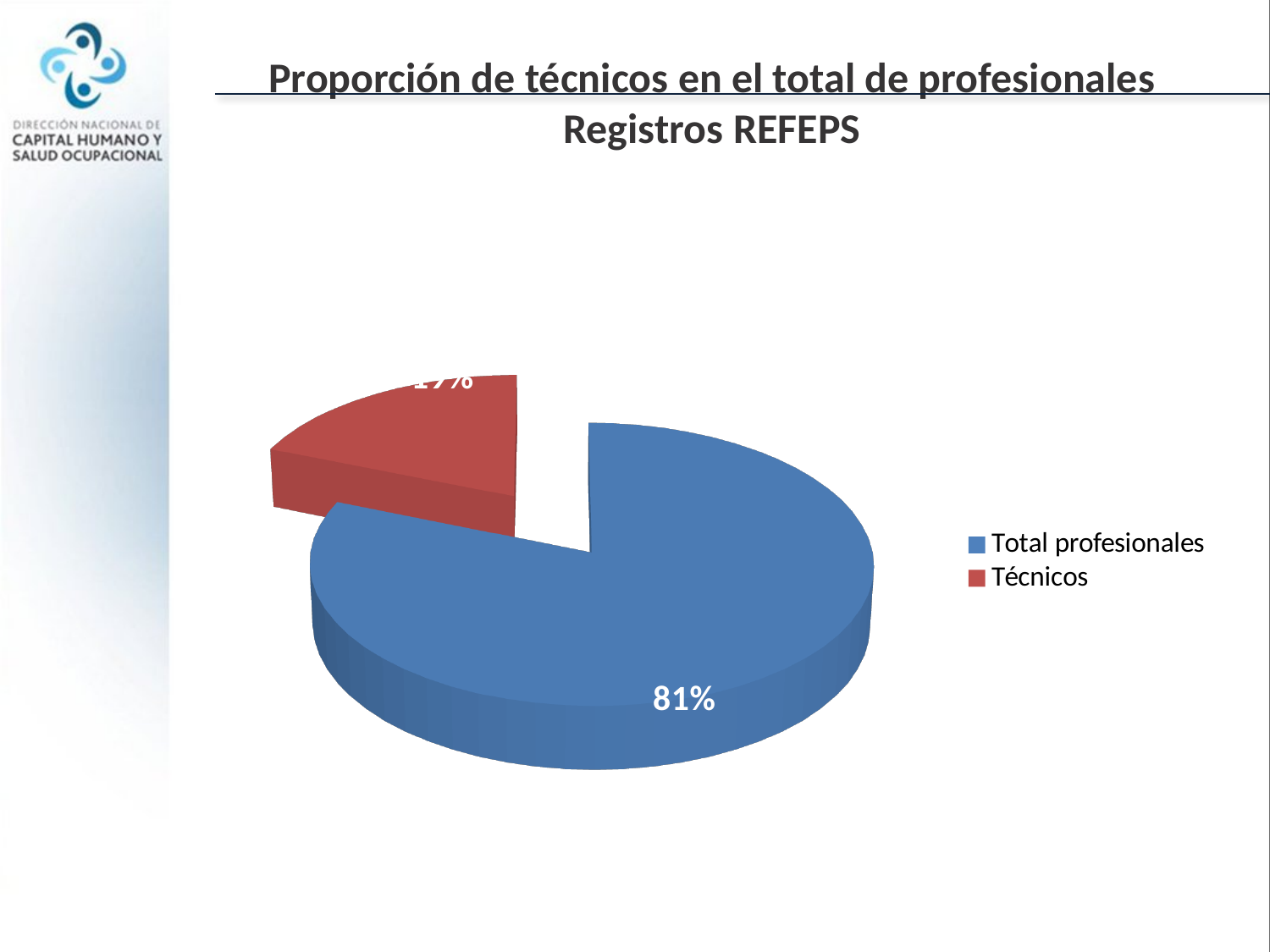
Which slice of the pie is the largest? Total profesionales Which slice of the pie is the smallest? Técnicos Which is larger, the Total profesionales slice or the Técnicos slice? Total profesionales What colour is the Técnicos slice? red How many entries does the legend list? 2 What kind of chart is shown on the slide? pie chart What is the title of the chart? Proporción de técnicos en el total de profesionales Registros REFEPS How many slices does the pie chart have? 2 What share of the pie does Total profesionales represent? 81% What is the value shown for the Total profesionales slice? 81%